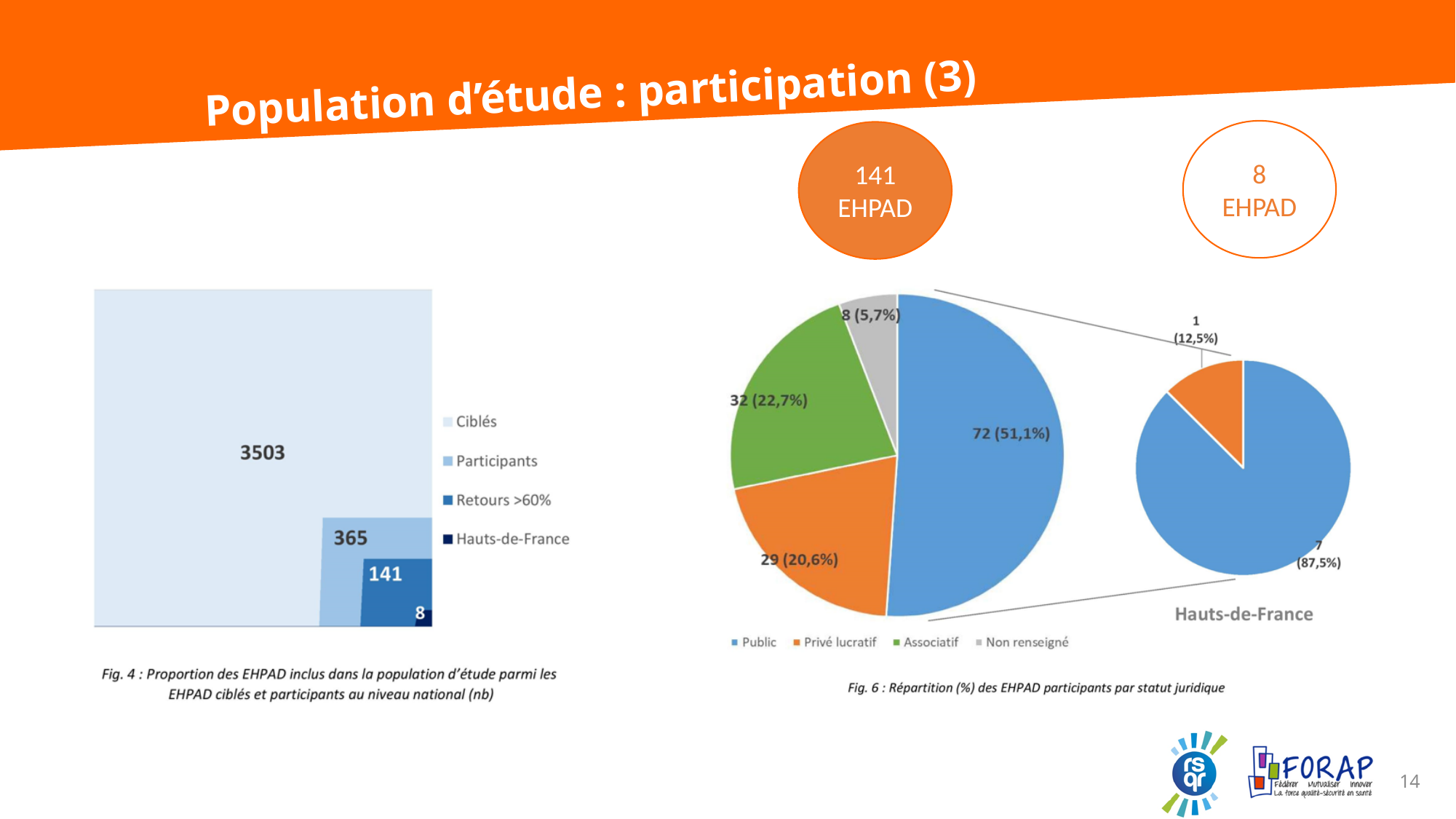
In Fig. 4, how many entries does the legend list? 4 In Fig. 4, what is the difference between the Participants value and the Retours >60% value? 224 In Fig. 4, what is the value shown for Retours >60%? 141 In Fig. 6, what is the label shown for the Public slice of the main pie? 72 (51,1%) In Fig. 6, which is larger in the main pie: Associatif or Privé lucratif? Associatif In Fig. 6, what share of the Hauts-de-France pie is Public? 87,5% What kind of chart is Fig. 6? Pie chart In Fig. 6, what share of the main pie is Associatif? 22,7% In Fig. 6, which category has the smallest slice of the main pie? Non renseigné In Fig. 4, what is the value shown for Ciblés? 3503 In Fig. 6, which category has the largest slice of the main pie? Public In Fig. 4, what is the value shown for Participants? 365